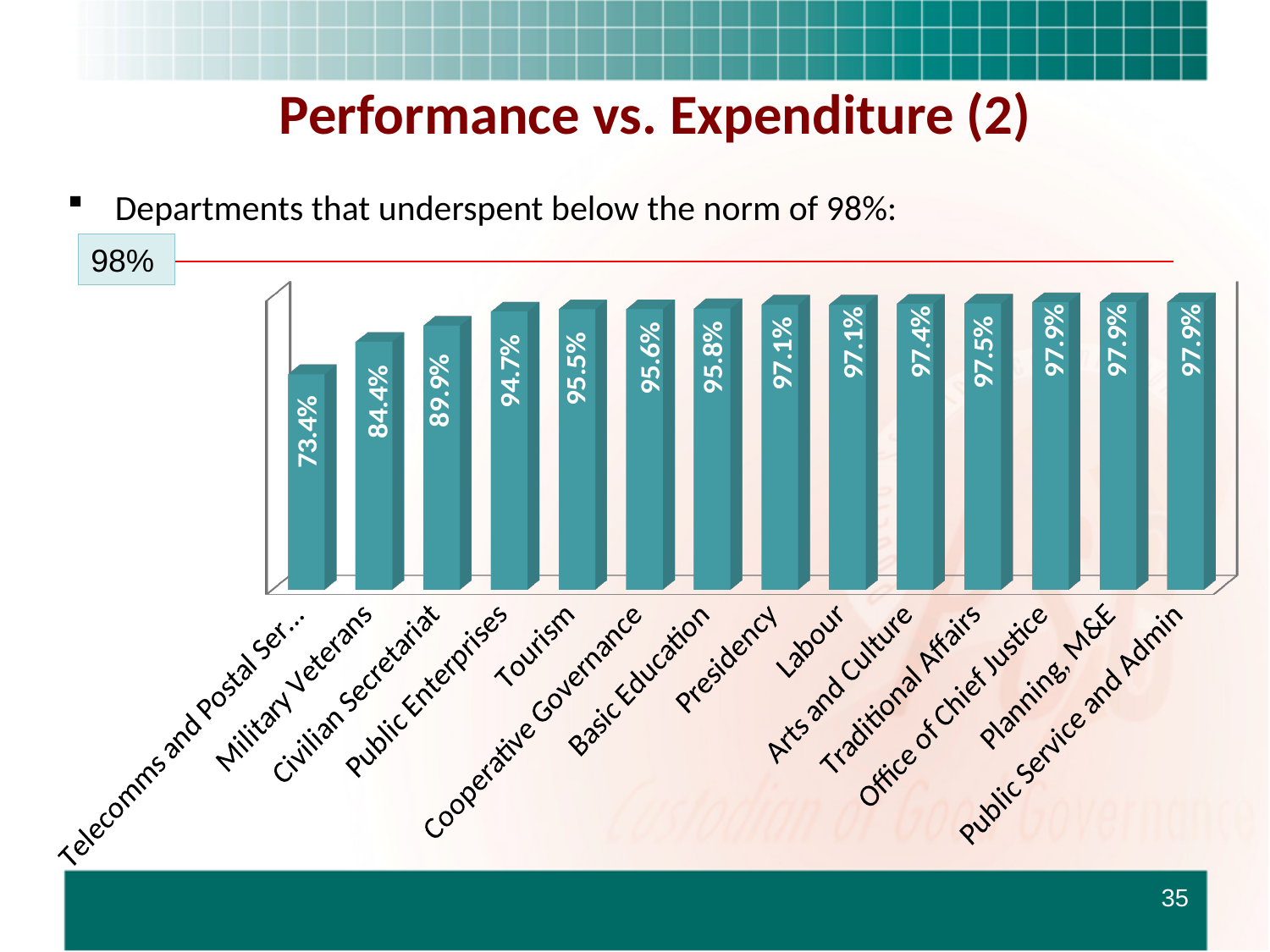
What kind of chart is shown on the slide? Bar chart What is the value for Public Service and Admin? 97.9% What is the lowest value shown on the chart? 73.4% What is the value for Military Veterans? 84.4% How many departments are shown on the chart? 14 What is the difference between the values for Tourism and Public Enterprises? 0.8 percentage points What is the value for Basic Education? 95.8% What is the difference between the values for Civilian Secretariat and Military Veterans? 5.5 percentage points What is the value for Tourism? 95.5% Which has a higher value, Civilian Secretariat or Military Veterans? Civilian Secretariat Do the values rise or fall from left to right along the x axis? Rise What is the value for Traditional Affairs? 97.5%